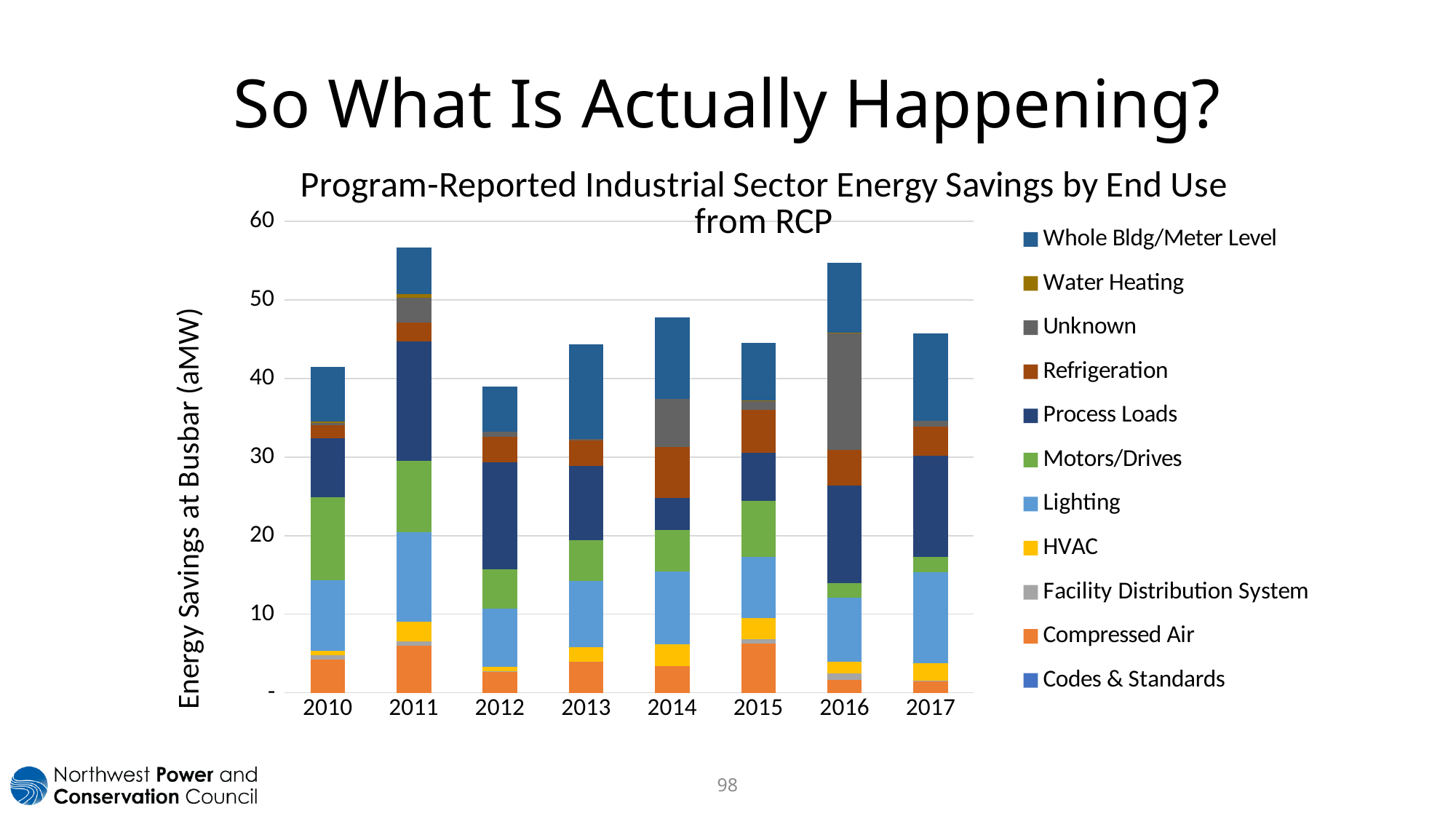
What kind of chart is shown on the slide? Stacked bar chart How many series does the chart's legend list? 11 What is the label on the vertical axis of the chart? Energy Savings at Busbar (aMW) How many years are shown on the x axis of the chart? 8 Is the total energy savings for 2014 greater or less than 50 aMW? less Is the total energy savings for 2011 greater or less than 50 aMW? greater What is the title of the chart? Program-Reported Industrial Sector Energy Savings by End Use from RCP Is the total energy savings for 2016 greater or less than 50 aMW? greater Which year has the larger total energy savings, 2011 or 2012? 2011 Which year has the tallest stacked bar (highest total energy savings)? 2011 Which year has the larger total energy savings, 2016 or 2010? 2016